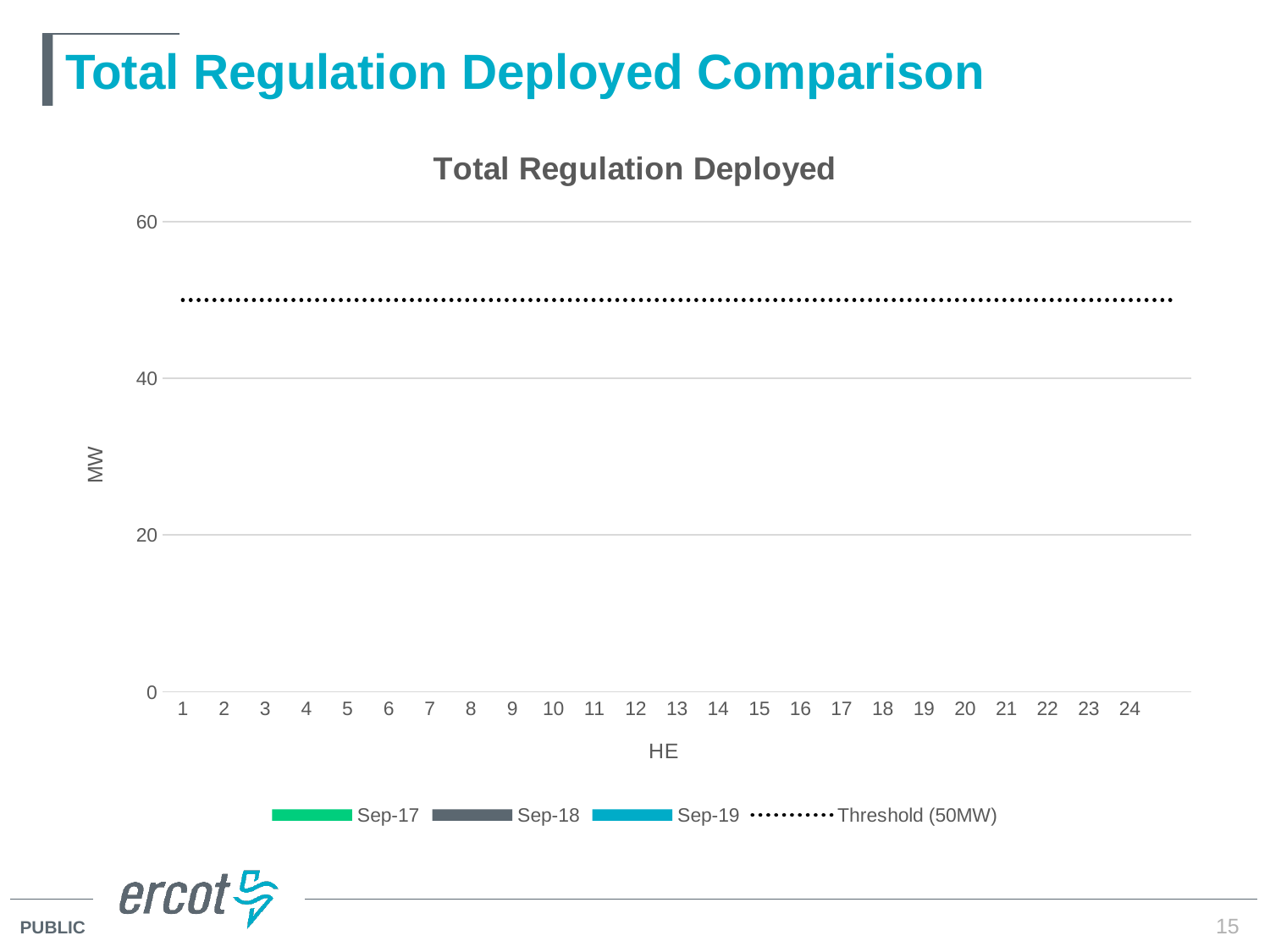
What is the highest value shown on the y axis? 60 What is the title of the chart? Total Regulation Deployed What is the label of the y axis? MW Is the Threshold line plotted greater or less than 40 on the MW axis? greater Is the Threshold line plotted greater or less than 60 on the MW axis? less How many hour-ending (HE) categories are shown on the x axis? 24 How many entries does the chart legend list? 4 Does the Threshold line rise, fall, or stay flat across the hours on the x axis? stays flat What value does the Threshold line represent, according to the legend? 50MW